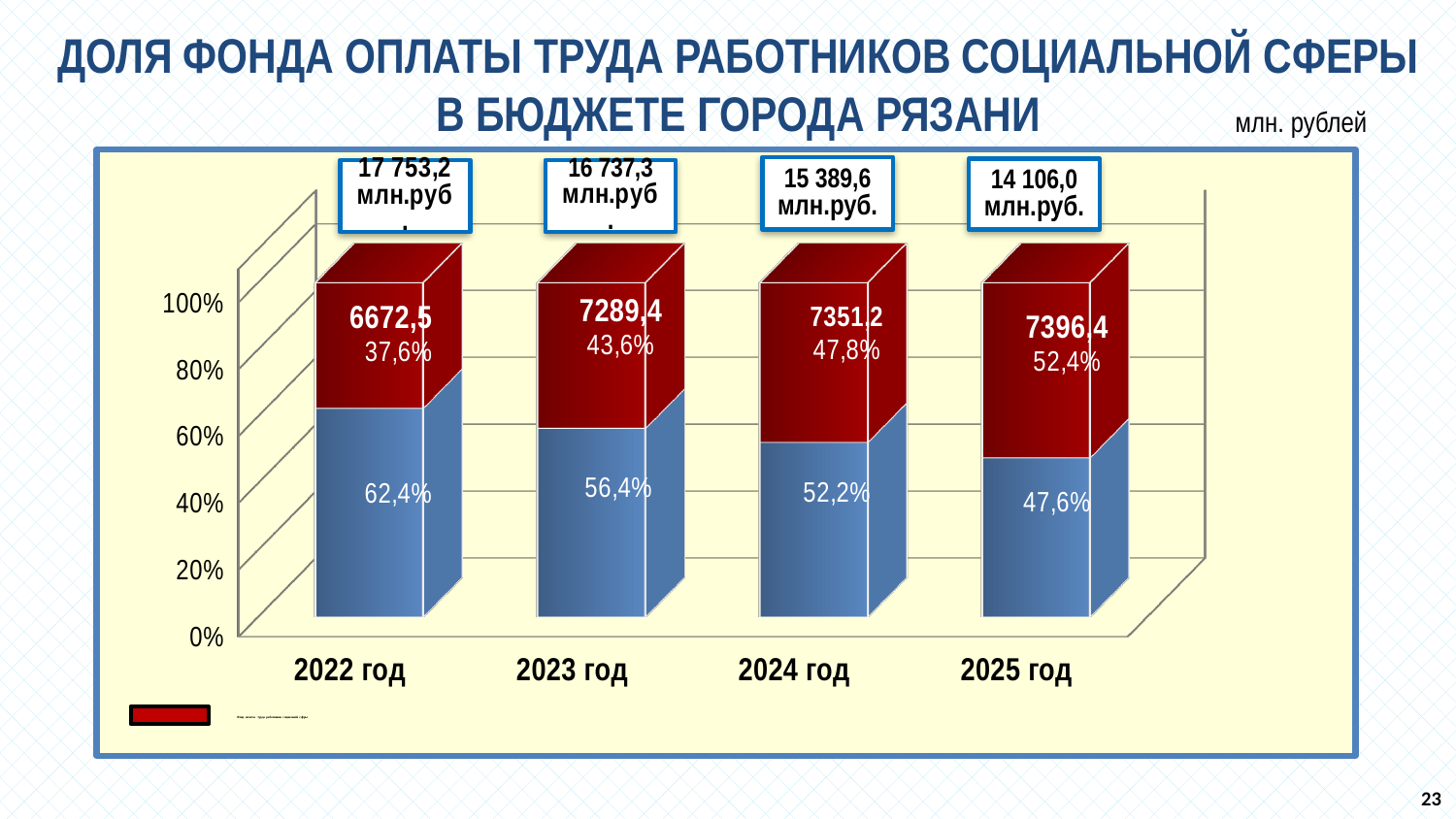
What is the difference between the totals shown above the bars for 2022 год and 2025 год? 3 647,2 What kind of chart is shown on the slide? bar chart Which year has the highest percentage on the red segment? 2025 год Does the percentage on the red segment rise or fall from 2022 год to 2025 год? rise For 2022 год, is the red segment's percentage larger or smaller than the blue segment's percentage? smaller Which year has the lowest total shown above its bar? 2025 год What percentage is shown on the blue segment for 2024 год? 52,2% What is the value of the red segment for 2022 год? 6672,5 What percentage is shown on the red segment for 2025 год? 52,4% What is the difference between the red segment values for 2025 год and 2022 год? 723,9 What total is shown above the bar for 2023 год? 16 737,3 млн.руб. How many years are shown on the x axis? 4